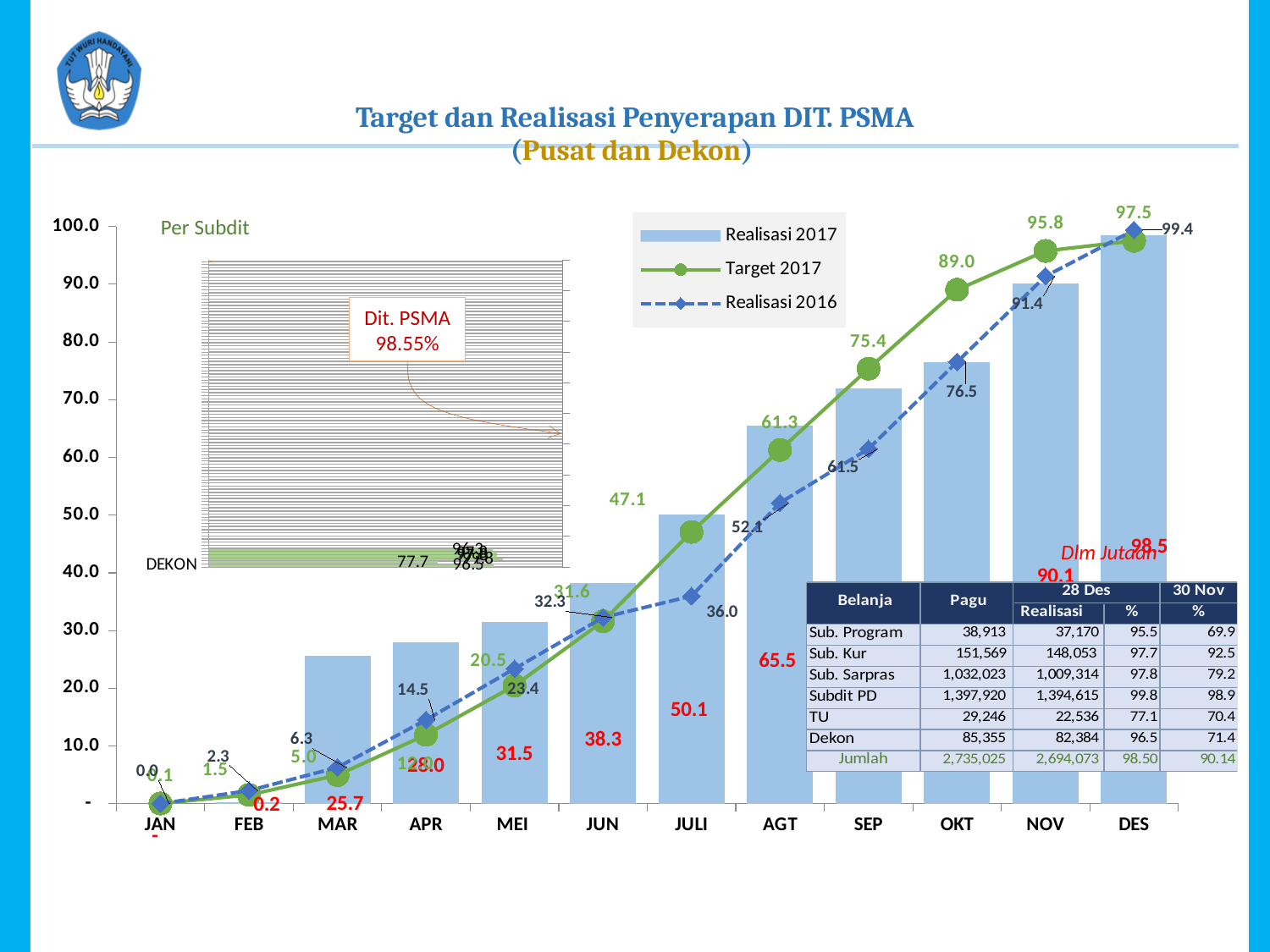
What is the Realisasi 2017 value for JULI? 50.1 In OKT, which is larger: Target 2017 or Realisasi 2016? Target 2017 Does the Target 2017 line rise or fall from JAN to DES? Rises In which month is the Target 2017 value highest? DES What is the Realisasi 2016 value for DES? 99.4 What kind of chart is the main chart on the slide? A combined bar and line chart What is the Target 2017 value for OKT? 89.0 Is the Realisasi 2017 bar for OKT greater or less than 70? greater How many months are shown on the x axis of the main chart? 12 What is the Target 2017 value for AGT? 61.3 What is the difference between the Realisasi 2016 value and the Target 2017 value in DES? 1.9 How many series does the legend of the main chart list? 3